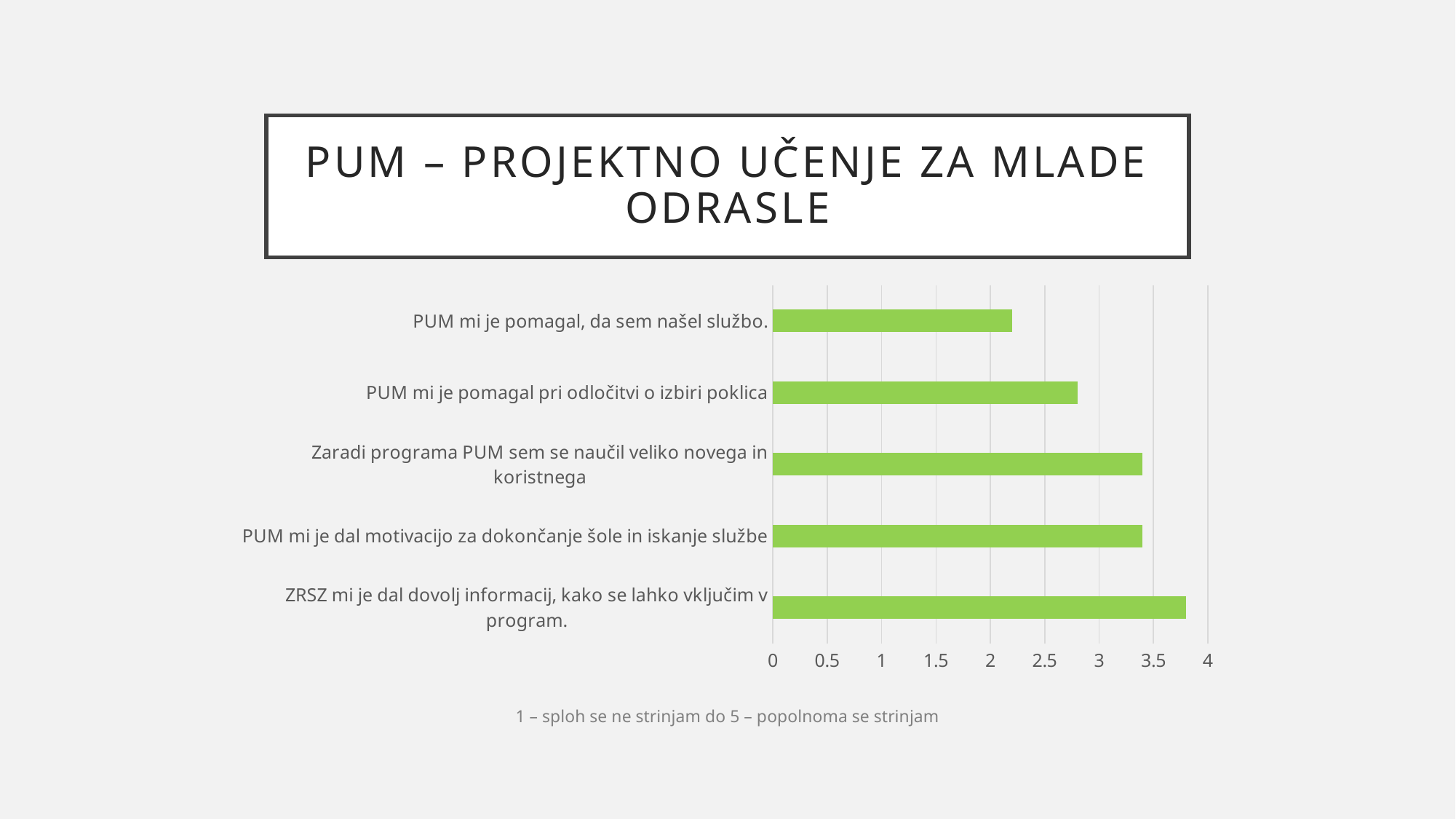
Is the value for "Zaradi programa PUM sem se naučil veliko novega in koristnega" greater or less than 3? greater How many categories (statements) are plotted in the chart? 5 Is the value for "PUM mi je pomagal pri odločitvi o izbiri poklica" greater or less than 3? less Which statement has the lowest value in the chart? PUM mi je pomagal, da sem našel službo. What kind of chart is shown on the slide? bar chart Is the value for "PUM mi je pomagal, da sem našel službo." greater or less than 2? greater Which has a larger value: "ZRSZ mi je dal dovolj informacij, kako se lahko vključim v program." or "PUM mi je pomagal pri odločitvi o izbiri poklica"? ZRSZ mi je dal dovolj informacij, kako se lahko vključim v program. What is the maximum value shown on the horizontal axis of the chart? 4 Which statement has the highest value in the chart? ZRSZ mi je dal dovolj informacij, kako se lahko vključim v program.